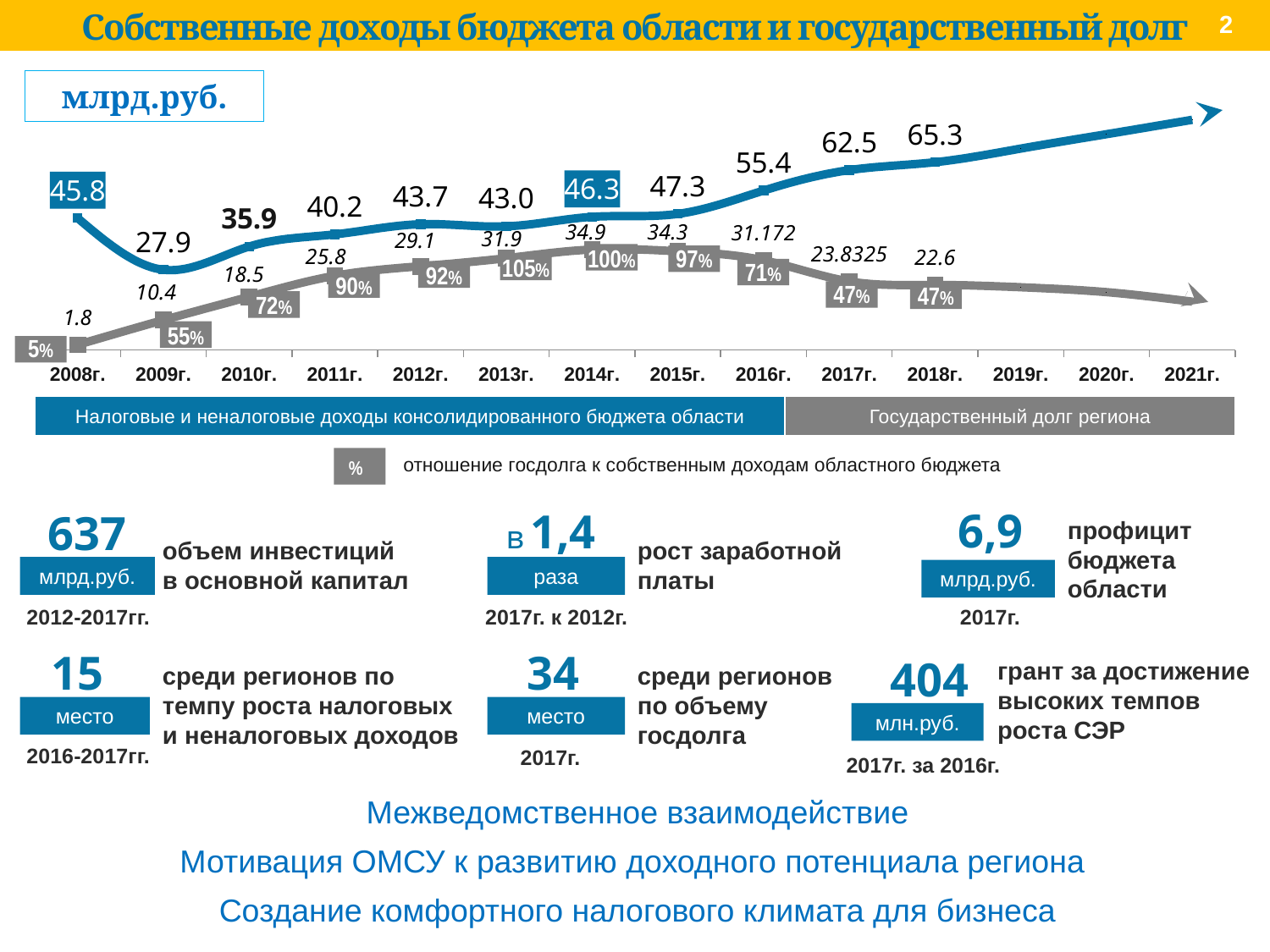
What is the difference between tax and non-tax revenues in 2017г. and 2016г.? 7.1 What unit is shown in the box at the top left of the chart? млрд.руб. What is the value of state debt (Государственный долг региона) for 2013г.? 31.9 What type of chart is shown on the slide? line chart What is the value of tax and non-tax revenues (Налоговые и неналоговые доходы) for 2018г.? 65.3 In which year is the tax and non-tax revenues value lowest among the labelled points? 2009г. How many years are labelled on the x axis? 14 How many series does the chart legend list? 2 Which is larger in 2012г.: tax and non-tax revenues or state debt? tax and non-tax revenues In which year is the state debt value highest among the labelled points? 2014г. What is the ratio of state debt to own revenues shown for 2013г.? 105% Do the tax and non-tax revenues rise or fall from 2013г. to 2018г.? rise